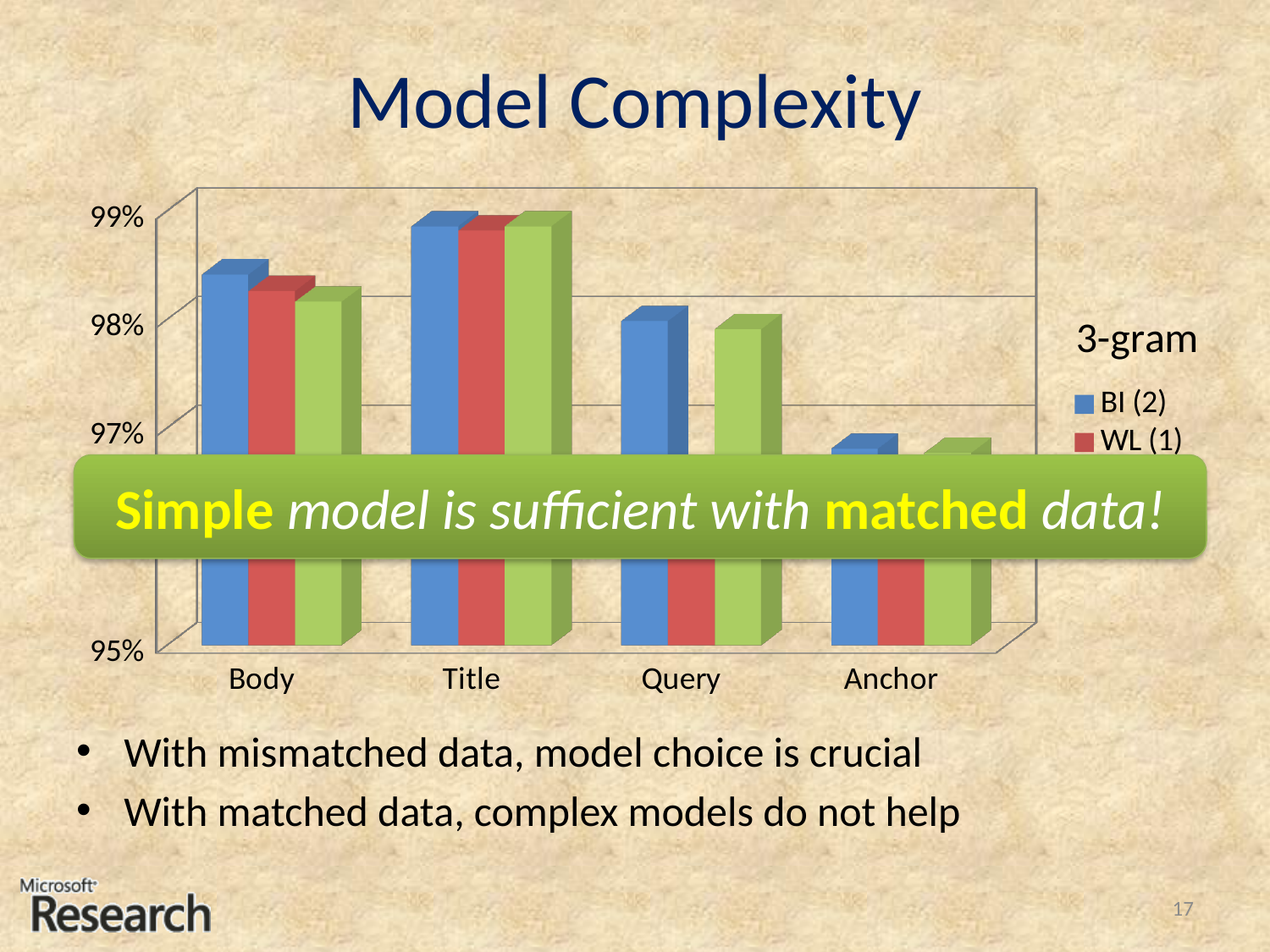
For the Body category, which is larger: the BI (2) value or the WL (1) value? BI (2) What is the title shown above the legend of the chart? 3-gram Which category has the lowest value for the BI (2) series? Anchor How many bars are plotted for each category in the chart? 3 How many categories are shown on the x axis of the chart? 4 Is the WL (1) value for Title greater or less than 98%? greater For the BI (2) series, which is larger: the value for Title or the value for Body? Title Is the BI (2) value for Query greater or less than 97%? greater Which category has the highest value for the BI (2) series? Title What kind of chart is shown on the slide? bar chart Is the BI (2) value for Body greater or less than 98%? greater